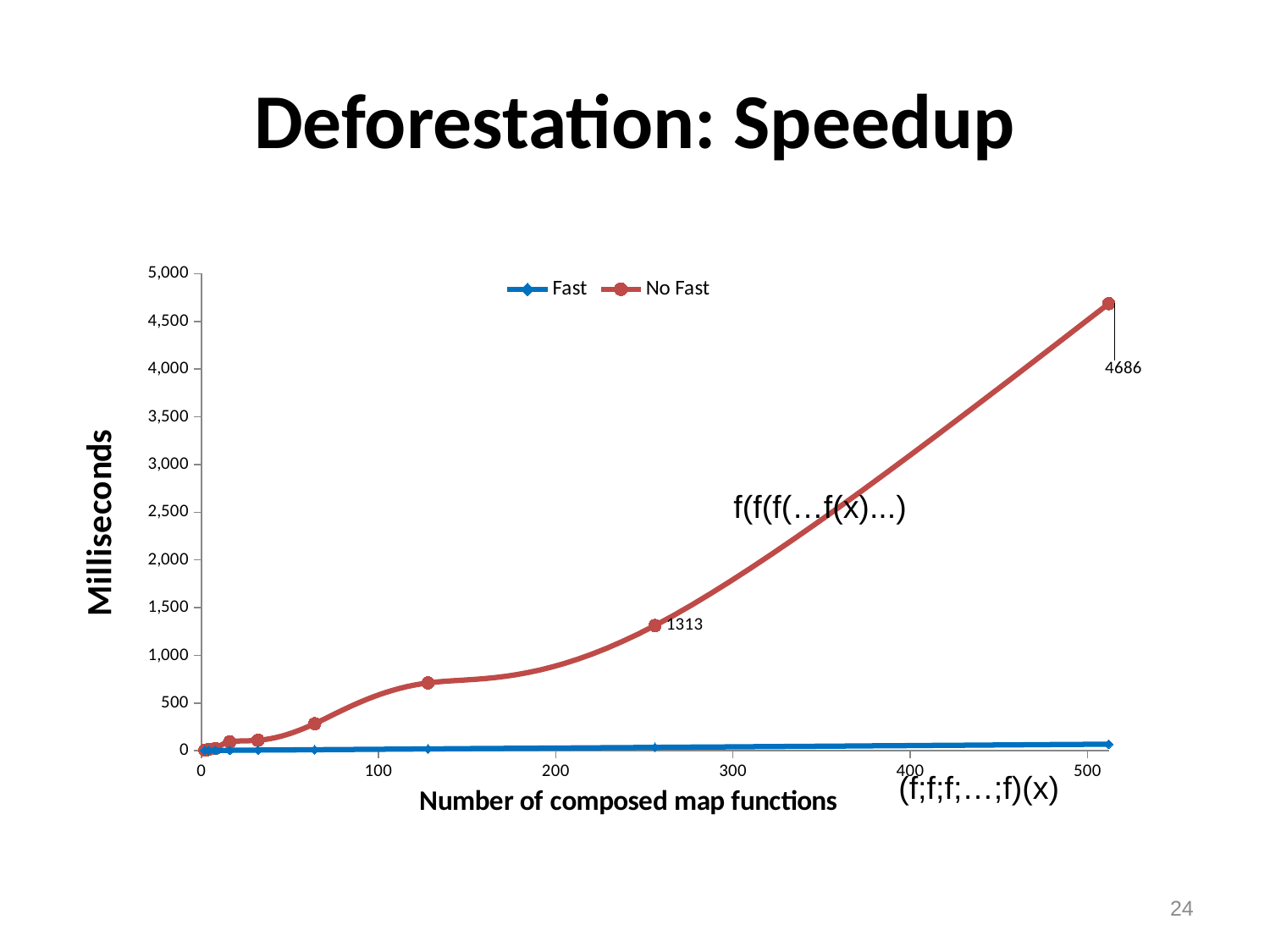
What is the highest labeled value for the No Fast series? 4686 What is the label on the y axis? Milliseconds What are the two series named in the legend? Fast and No Fast How many series does the legend list? 2 What kind of chart is shown on the slide? line chart What is the difference between the two labeled No Fast values, 4686 and 1313? 3373 What value is labeled on the No Fast series at roughly 256 composed map functions? 1313 Is the value for the Fast series at about 500 composed map functions greater or less than 500? less Does the No Fast series rise or fall as the number of composed map functions increases? rise At the right end of the chart (around 500 composed map functions), which series has the larger value, Fast or No Fast? No Fast Which series reaches the highest value in milliseconds? No Fast Is the value for the No Fast series at about 128 composed map functions greater or less than 1,000? less